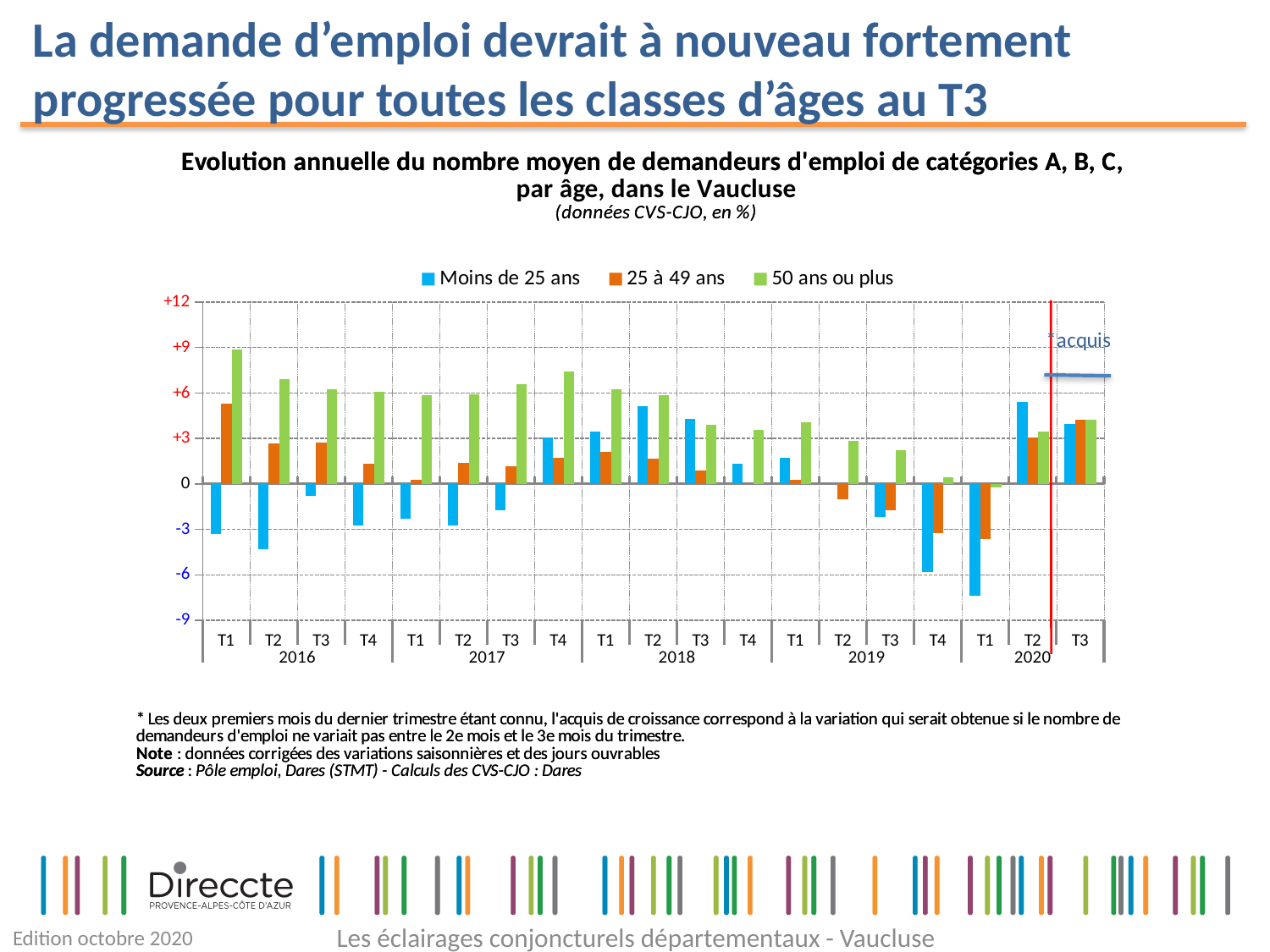
Which series is shown in blue in the legend? Moins de 25 ans In T1 2016, which is larger: the value for '50 ans ou plus' or the value for '25 à 49 ans'? 50 ans ou plus How many series does the legend list? 3 What kind of chart is shown on the slide? bar chart How many quarters are plotted along the x axis? 19 In which quarter is the value for '50 ans ou plus' the highest? T1 2016 Is the value for 'Moins de 25 ans' in T1 2020 greater or less than -6? less Is the value for '50 ans ou plus' in T1 2016 greater or less than +6? greater Which year's quarters are separated by a red vertical line marking the 'acquis' value? 2020 Is the value for '25 à 49 ans' in T1 2016 greater or less than +3? greater In which quarter is the value for 'Moins de 25 ans' the lowest? T1 2020 In T2 2020, which is larger: the value for 'Moins de 25 ans' or the value for '25 à 49 ans'? Moins de 25 ans